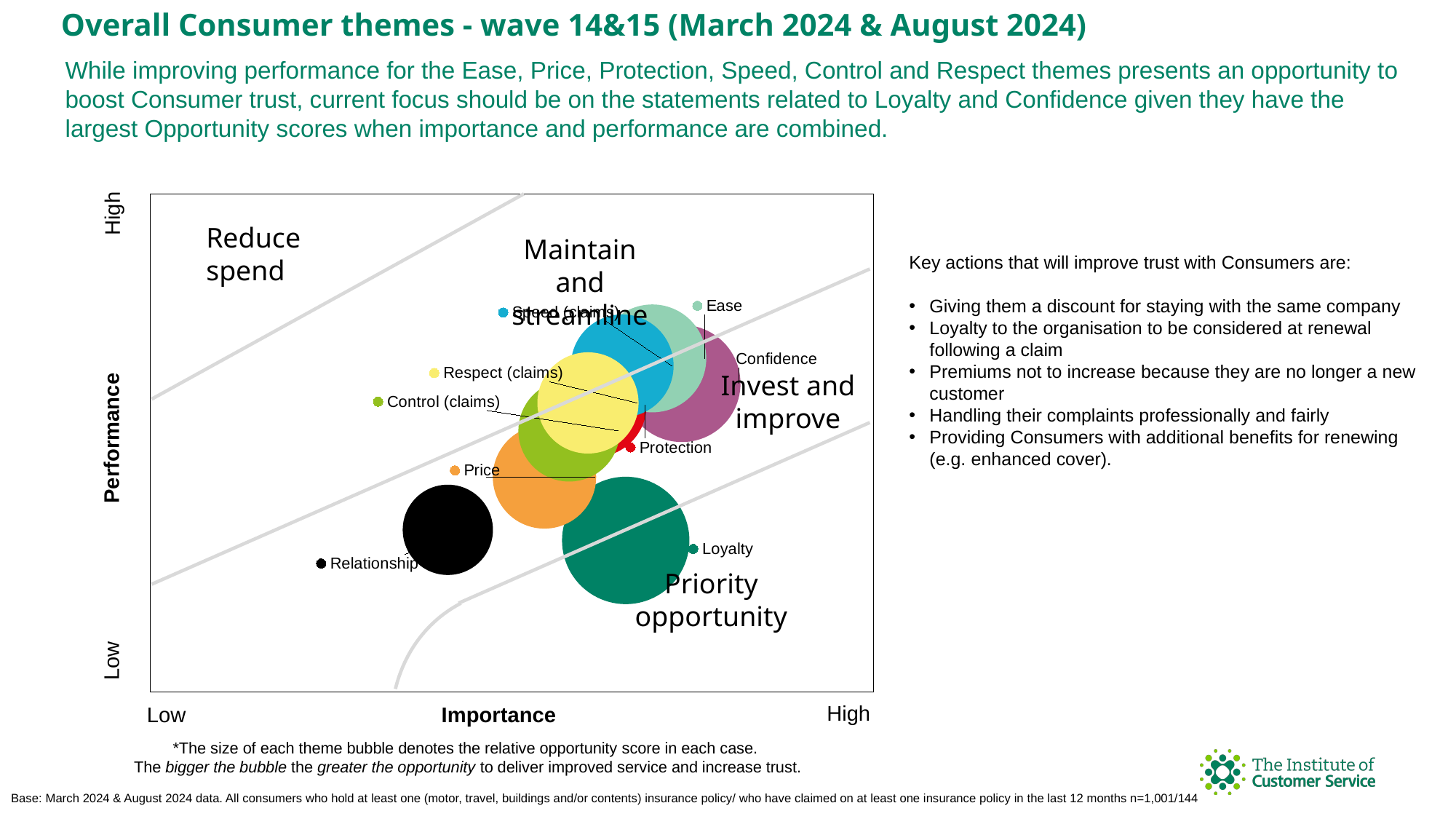
What is the label of the horizontal axis of the chart? Importance How many theme bubbles are plotted on the chart? 9 Which has higher Importance, Loyalty or Relationship? Loyalty Which theme has the lowest Importance on the chart? Relationship What kind of chart is shown on the slide? Bubble chart Which has higher Performance, Ease or Loyalty? Ease What colour is the Loyalty bubble? Green Which theme has the largest bubble on the chart? Loyalty Which theme bubble sits in the 'Invest and improve' area of the chart? Confidence Which theme has the highest Importance on the chart? Confidence Which theme bubble sits in the 'Priority opportunity' area of the chart? Loyalty Which theme has the lowest Performance on the chart? Loyalty